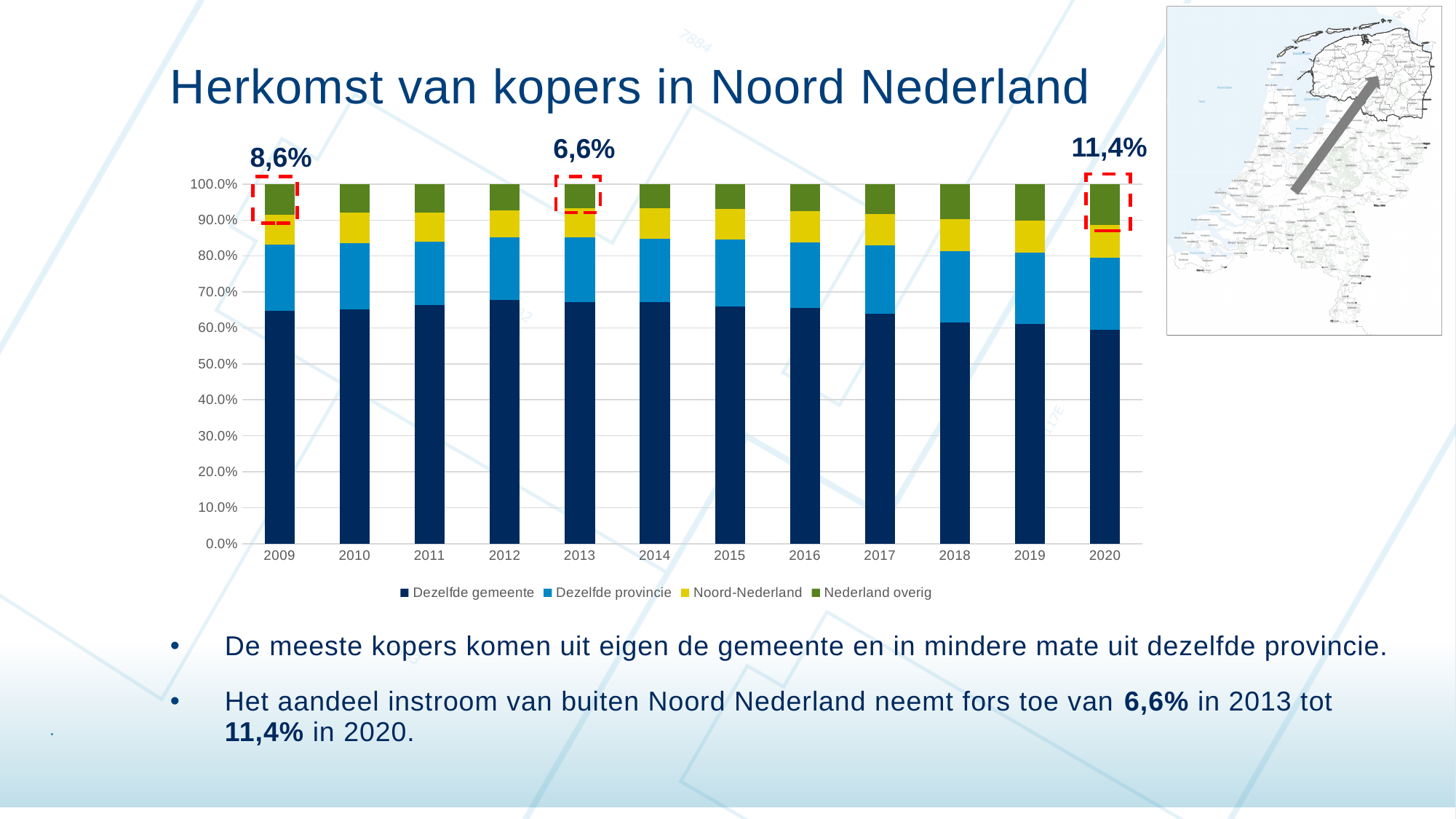
Of the three labelled years (2009, 2013, 2020), which has the lowest share of Nederland overig? 2013 What is the share of Nederland overig in 2020? 11,4% How many years are shown on the x axis of the chart? 12 What is the share of Nederland overig in 2009? 8,6% Does the share of Dezelfde gemeente rise or fall from 2012 to 2020? fall How many series does the legend list? 4 Is the value for Dezelfde gemeente in 2012 greater or less than 60%? greater What kind of chart is shown on the slide? Stacked bar chart Which is larger: the share of Nederland overig in 2009 or in 2020? 2020 By how many percentage points did the share of Nederland overig increase from 2013 to 2020? 4,8% What is the title of the chart slide? Herkomst van kopers in Noord Nederland What is the share of Nederland overig in 2013? 6,6%